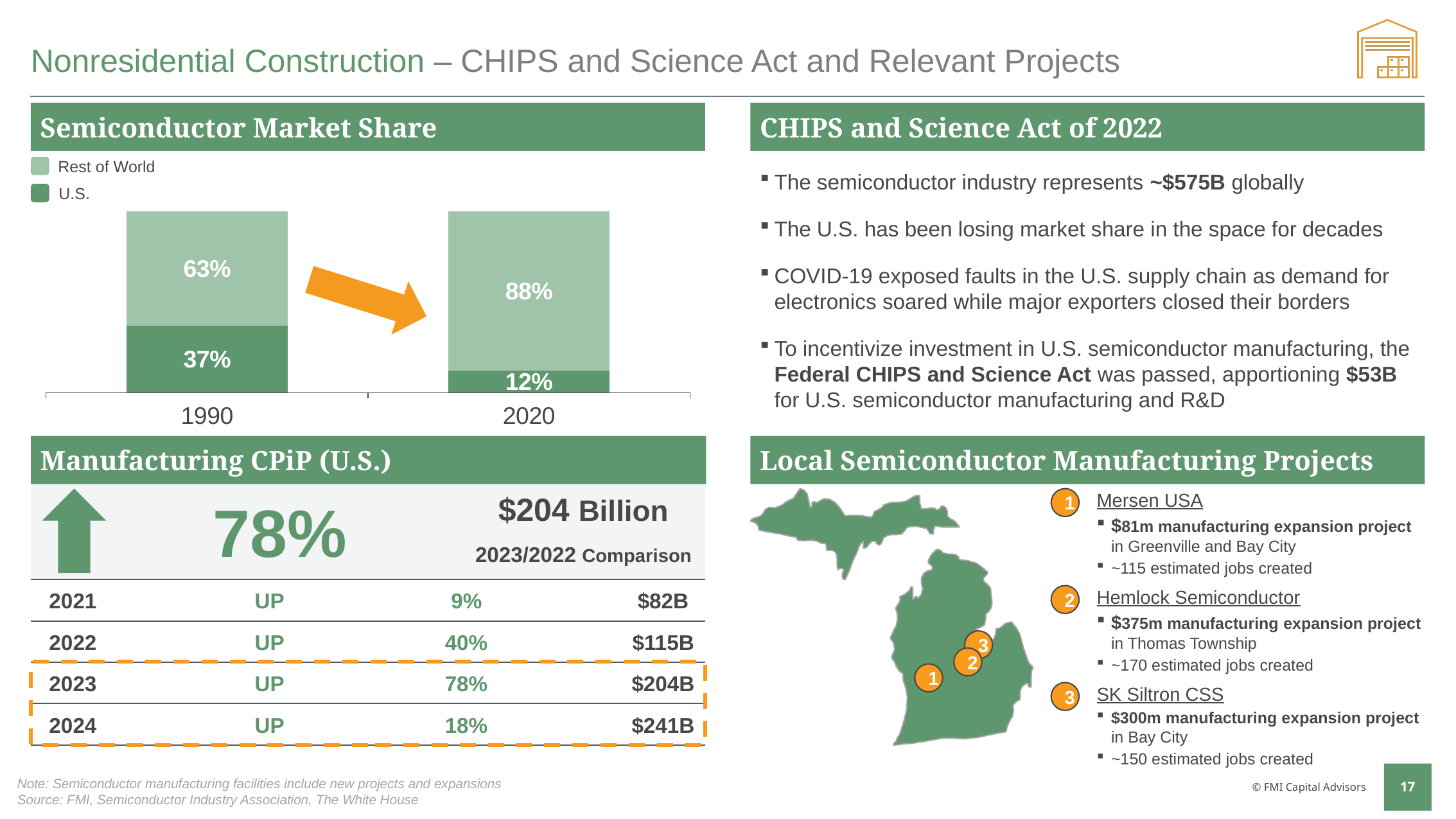
In the Semiconductor Market Share chart, does the U.S. share rise or fall from 1990 to 2020? Fall In the Semiconductor Market Share chart, in which year is the Rest of World share highest? 2020 How many series does the legend of the Semiconductor Market Share chart list? 2 In the Semiconductor Market Share chart, what is the Rest of World share in 2020? 88% In the Semiconductor Market Share chart, what is the Rest of World share in 1990? 63% How many years are shown on the x axis of the Semiconductor Market Share chart? 2 In the Semiconductor Market Share chart, by how many percentage points did the U.S. share fall from 1990 to 2020? 25 percentage points In the Semiconductor Market Share chart, what is the U.S. share in 2020? 12% What kind of chart is the Semiconductor Market Share chart? Stacked bar chart What are the two legend entries in the Semiconductor Market Share chart? Rest of World and U.S. In the Semiconductor Market Share chart, what is the U.S. share in 1990? 37% In the Semiconductor Market Share chart, is the U.S. share larger in 1990 or in 2020? 1990